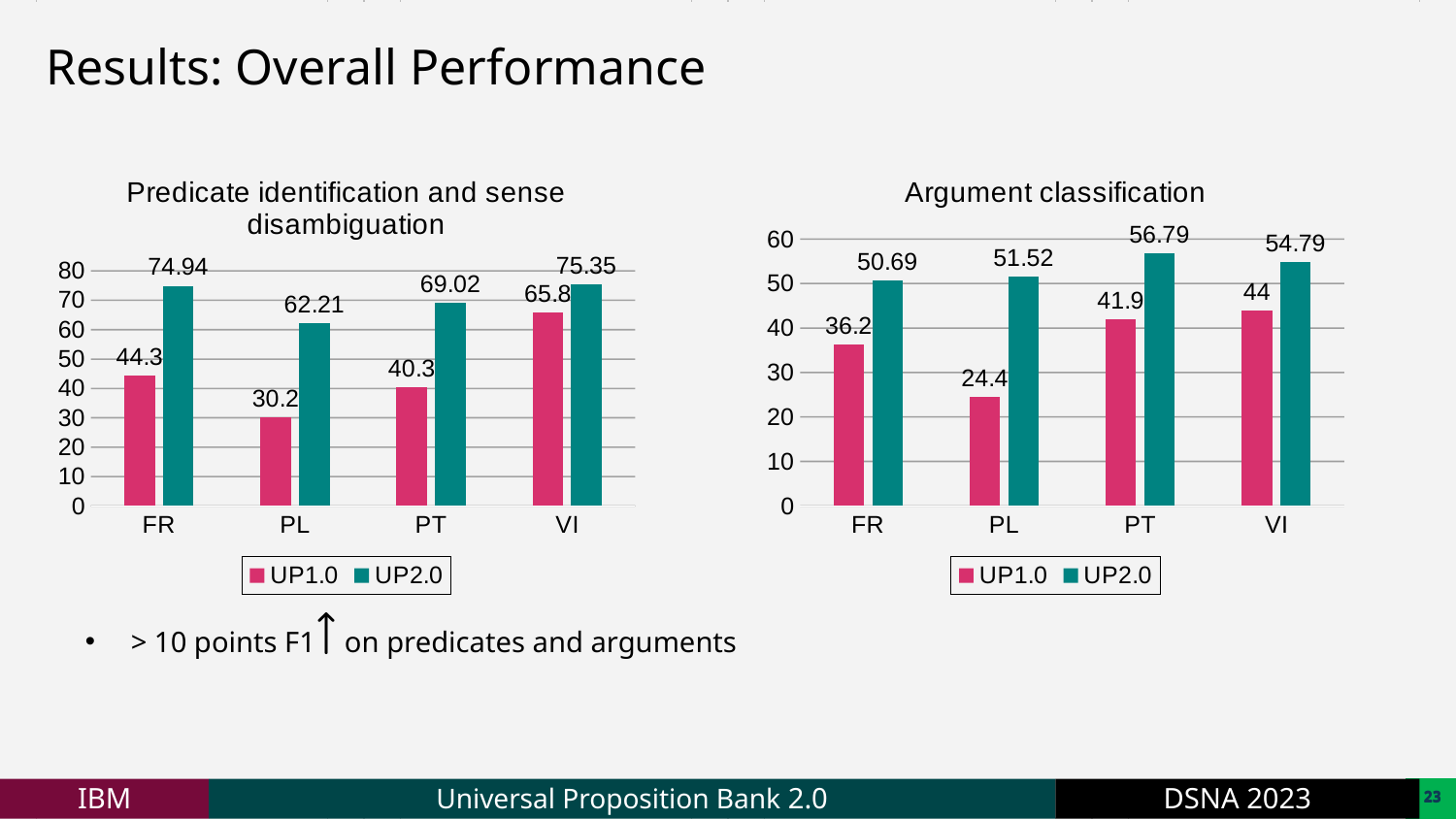
In the 'Predicate identification and sense disambiguation' chart, what is the UP2.0 value for PL? 62.21 How many languages are shown on the x axis of the 'Argument classification' chart? 4 In the 'Predicate identification and sense disambiguation' chart, what is the difference between the UP2.0 and UP1.0 values for FR? 30.64 In the 'Argument classification' chart, which language has the lowest UP1.0 value? PL What type of chart is the 'Argument classification' chart? Bar chart In the 'Argument classification' chart, what is the UP1.0 value for PT? 41.9 How many series does the legend of the 'Predicate identification and sense disambiguation' chart list? 2 In the 'Argument classification' chart, which language has the highest UP2.0 value? PT In the 'Predicate identification and sense disambiguation' chart, which language has the highest UP1.0 value? VI What are the two series named in the legend of the 'Argument classification' chart? UP1.0 and UP2.0 In the 'Predicate identification and sense disambiguation' chart, which is larger: the UP1.0 value for FR or the UP1.0 value for PT? FR In the 'Argument classification' chart, what is the difference between the UP2.0 and UP1.0 values for VI? 10.79